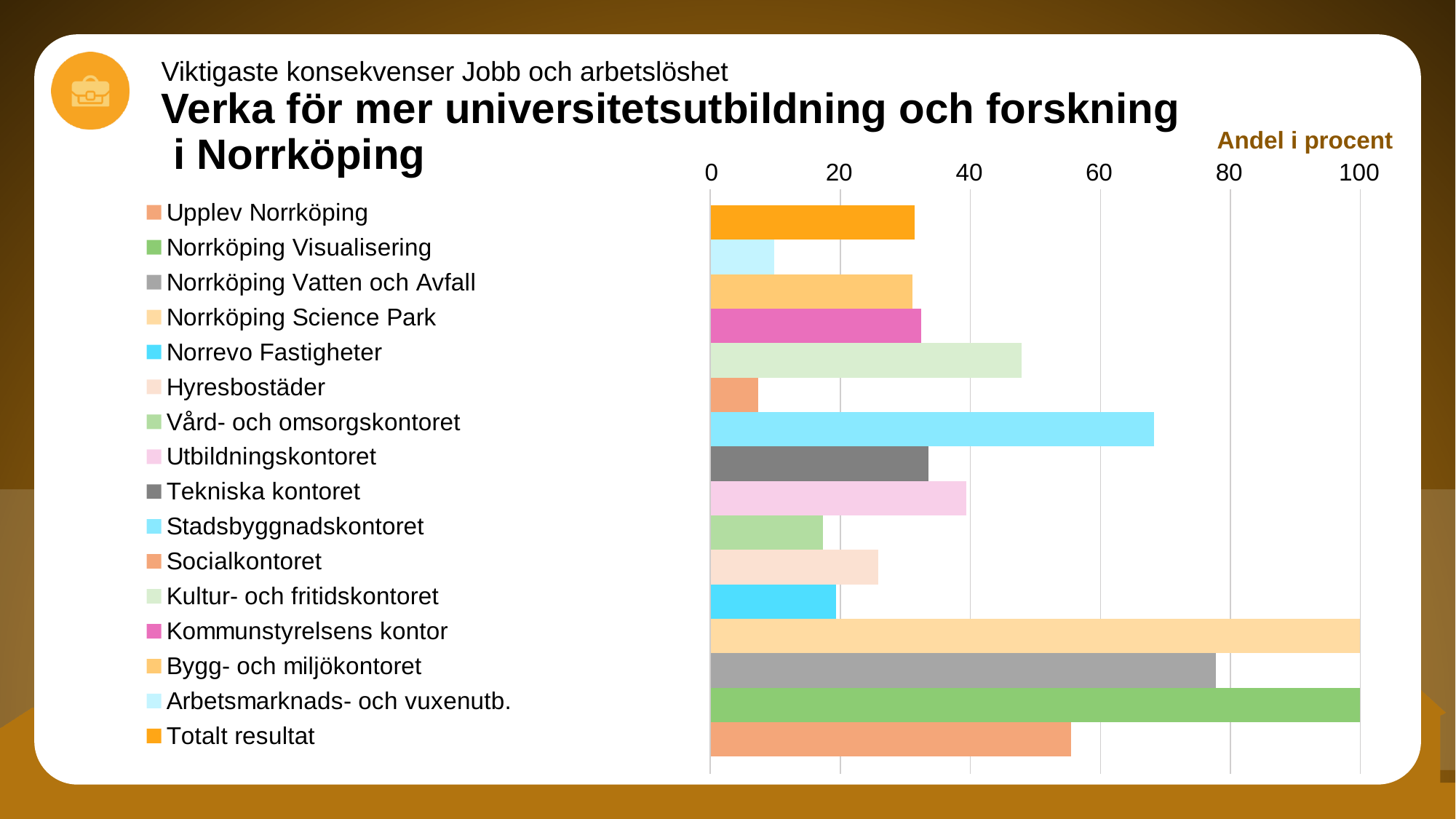
What kind of chart is shown on the slide? bar chart Is the value for Totalt resultat greater or less than 40? less Which is larger, the value for Upplev Norrköping or the value for Hyresbostäder? Upplev Norrköping What is the value for Norrköping Visualisering? 100 How many bars are plotted in the chart? 16 Which category has the lowest value? Socialkontoret What is the value for Norrköping Science Park? 100 How many entries does the legend list? 16 Which is larger, the value for Kultur- och fritidskontoret or the value for Vård- och omsorgskontoret? Kultur- och fritidskontoret Is the value for Stadsbyggnadskontoret greater or less than 60? greater Is the value for Norrköping Vatten och Avfall greater or less than 60? greater What label is shown above the value axis of the chart? Andel i procent